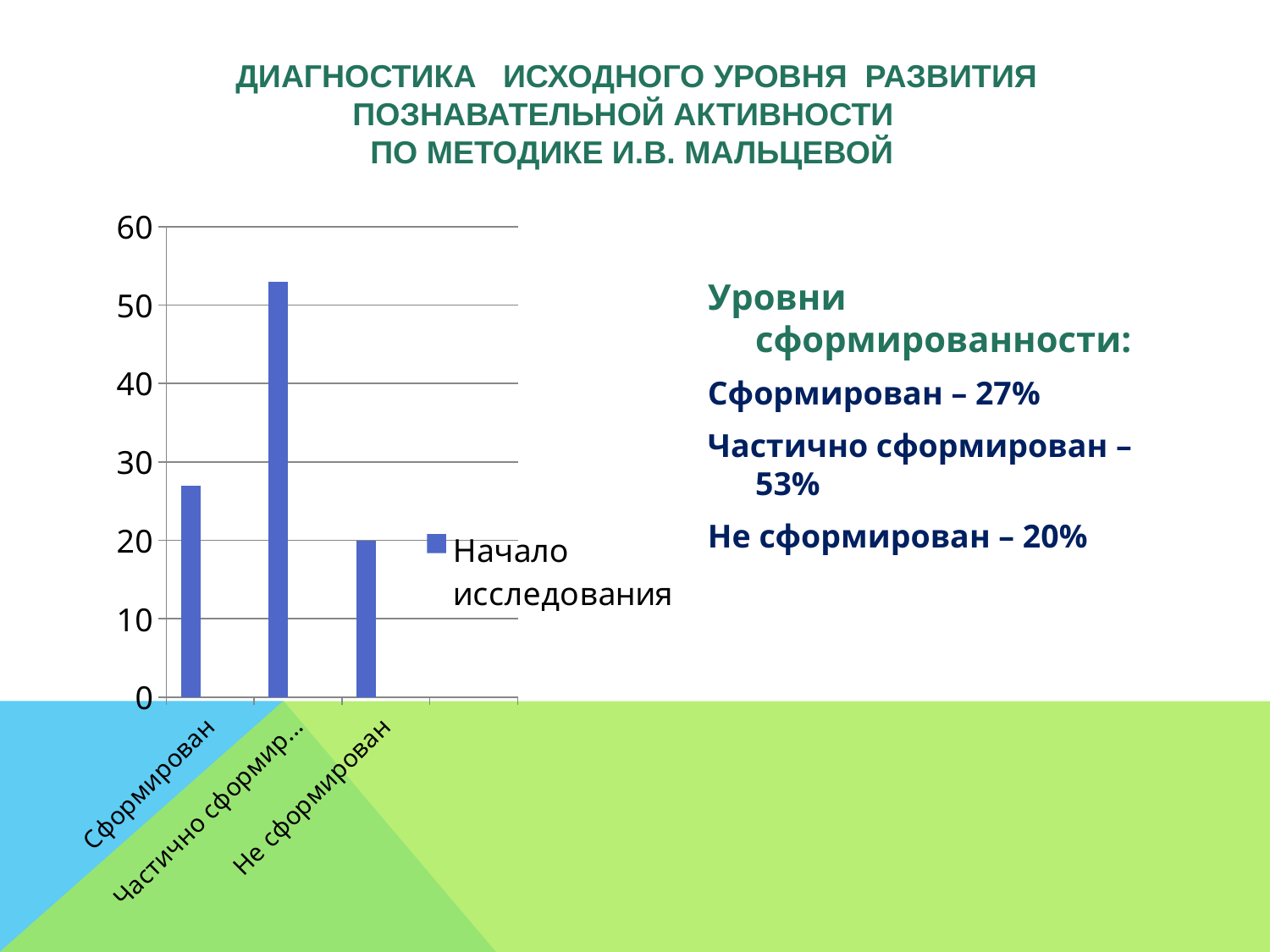
Is the value for Сформирован greater or less than 30? less How many categories are shown on the x axis of the chart? 3 What is the value for Не сформирован in the chart? 20 Is the value for Частично сформирован greater or less than 50? greater Which category has the lowest bar in the chart? Не сформирован How many series does the chart legend list? 1 Is the value for Сформирован greater or less than 20? greater What is the maximum value shown on the vertical axis of the chart? 60 Which category has the highest bar in the chart? Частично сформирован What is the name of the series in the chart legend? Начало исследования What type of chart is shown on the slide? bar chart Which is larger in the chart, the value for Сформирован or the value for Не сформирован? Сформирован